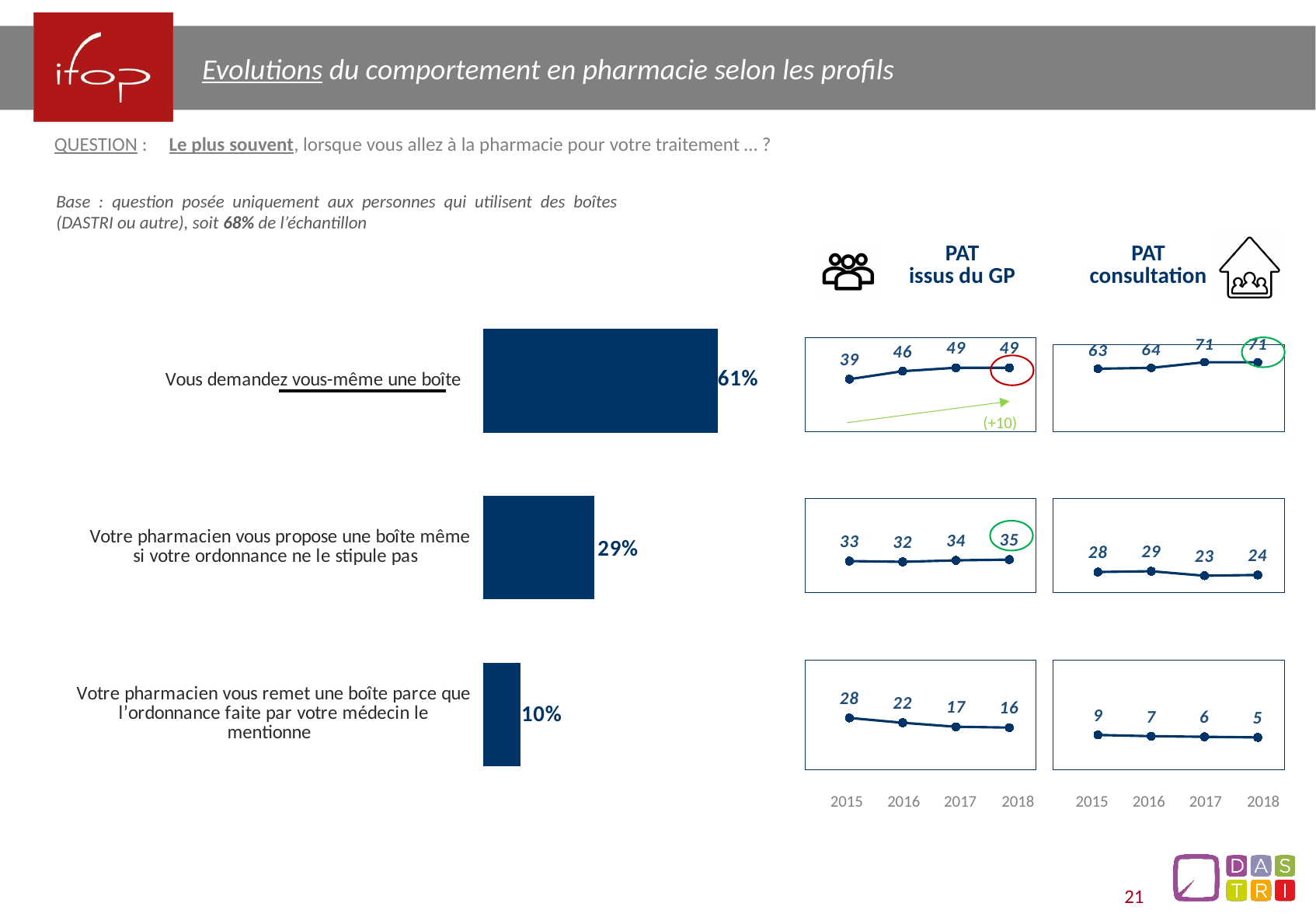
In the bar chart on the left, what is the value for "Vous demandez vous-même une boîte"? 61% In the "PAT issus du GP" line chart for "Vous demandez vous-même une boîte", what is the value for 2015? 39 In the bar chart on the left, what is the value for "Votre pharmacien vous remet une boîte parce que l'ordonnance faite par votre médecin le mentionne"? 10% How many bars are in the bar chart on the left? 3 In the "PAT issus du GP" line chart for "Vous demandez vous-même une boîte", do the values rise or fall from 2015 to 2018? Rise In the bar chart on the left, what is the difference between the values for "Vous demandez vous-même une boîte" and "Votre pharmacien vous propose une boîte même si votre ordonnance ne le stipule pas"? 32% In the "PAT consultation" line chart for "Votre pharmacien vous propose une boîte même si votre ordonnance ne le stipule pas", which year has the lowest value? 2017 In the "PAT consultation" line chart for "Votre pharmacien vous remet une boîte parce que l'ordonnance faite par votre médecin le mentionne", do the values rise or fall from 2015 to 2018? Fall In the "PAT issus du GP" line chart for "Votre pharmacien vous remet une boîte parce que l'ordonnance faite par votre médecin le mentionne", what is the difference between the 2015 and 2018 values? 12 In the "PAT consultation" line chart for "Vous demandez vous-même une boîte", what is the value for 2018? 71 What kind of chart is used on the left side of the slide to show the 61%, 29% and 10% values? Bar chart In the bar chart on the left, which category has the highest value? Vous demandez vous-même une boîte